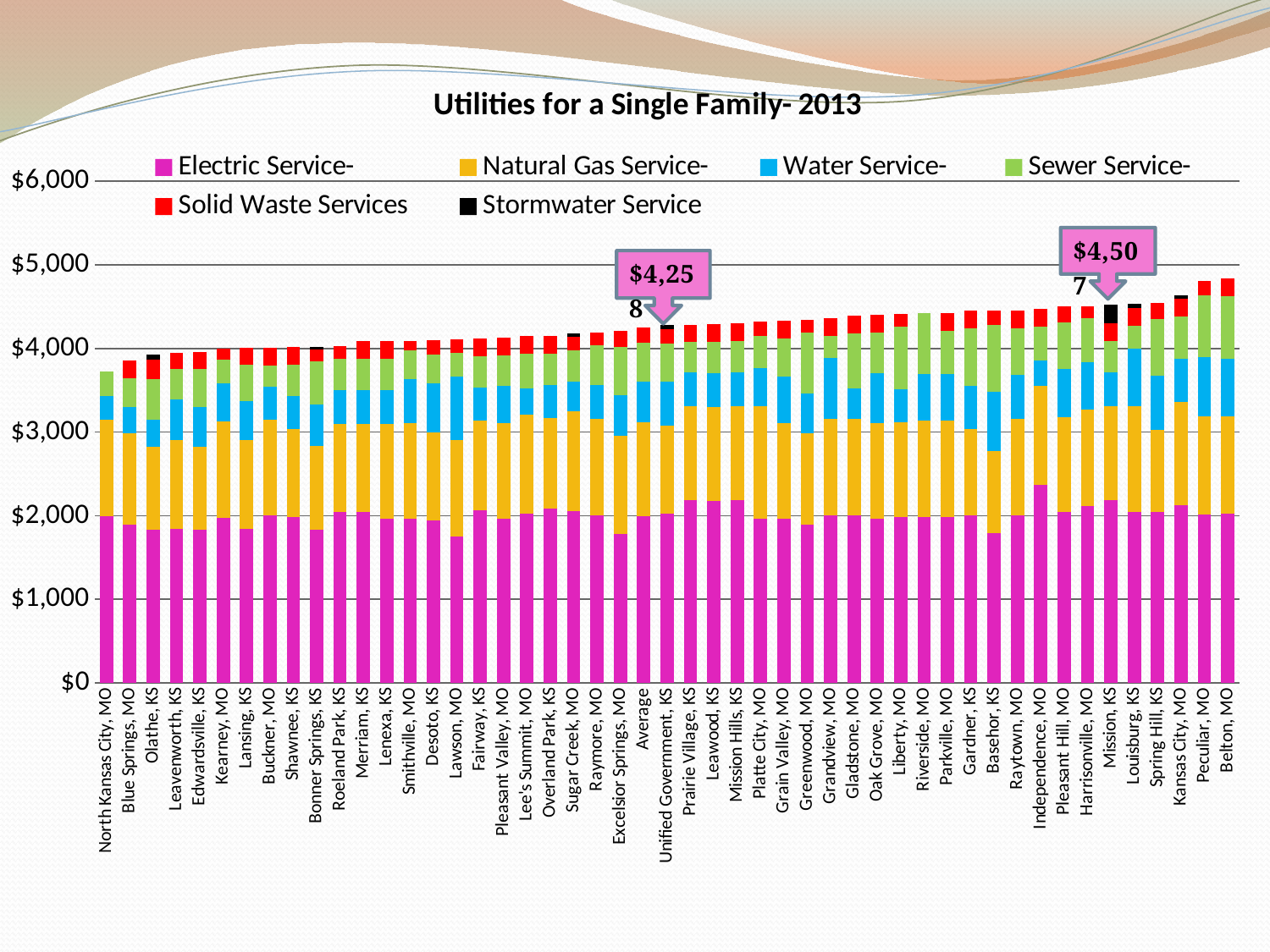
What is the difference between the total for Mission, KS and the Average total? $249 Is the total for North Kansas City, MO greater or less than $4,000? less Do the total utility costs generally rise or fall from left to right along the x axis? Rise Which city has the lowest total utility cost? North Kansas City, MO Which series forms the bottom segment of each stacked bar? Electric Service- How many series does the legend list? 6 What is the title of the chart? Utilities for a Single Family- 2013 What kind of chart is shown on the slide? Stacked bar chart What is the total utility cost shown for Average? $4,258 Is the total for Belton, MO greater or less than $4,000? greater What is the total utility cost shown for Mission, KS? $4,507 Which has the larger total utility cost, Belton, MO or North Kansas City, MO? Belton, MO